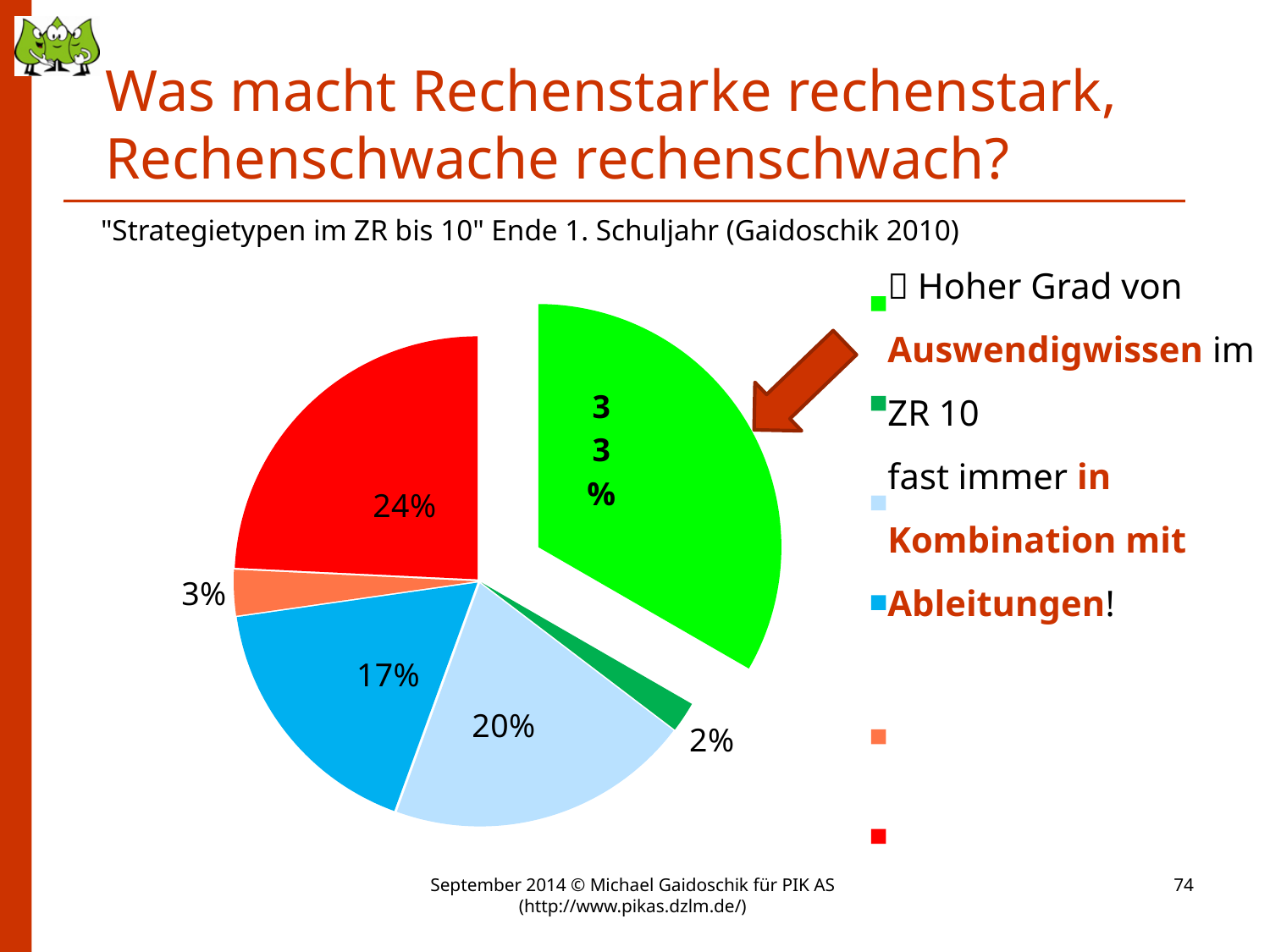
What percentage is shown on the red slice of the pie chart? 24% What is the largest share shown in the pie chart? 33% Which slice is larger, the red slice or the light blue slice? the red slice How many slices does the pie chart have? 6 What is the difference between the light blue slice (20%) and the darker blue slice (17%)? 3% What is the difference between the bright green slice (33%) and the red slice (24%)? 9% What percentage is shown on the orange slice of the pie chart? 3% Which slice of the pie chart is pulled out (exploded) from the rest? the bright green 33% slice What percentage is shown on the darker blue slice of the pie chart? 17% What kind of chart is shown on the slide? pie chart What percentage is shown on the light blue slice of the pie chart? 20% What is the smallest share shown in the pie chart? 2%